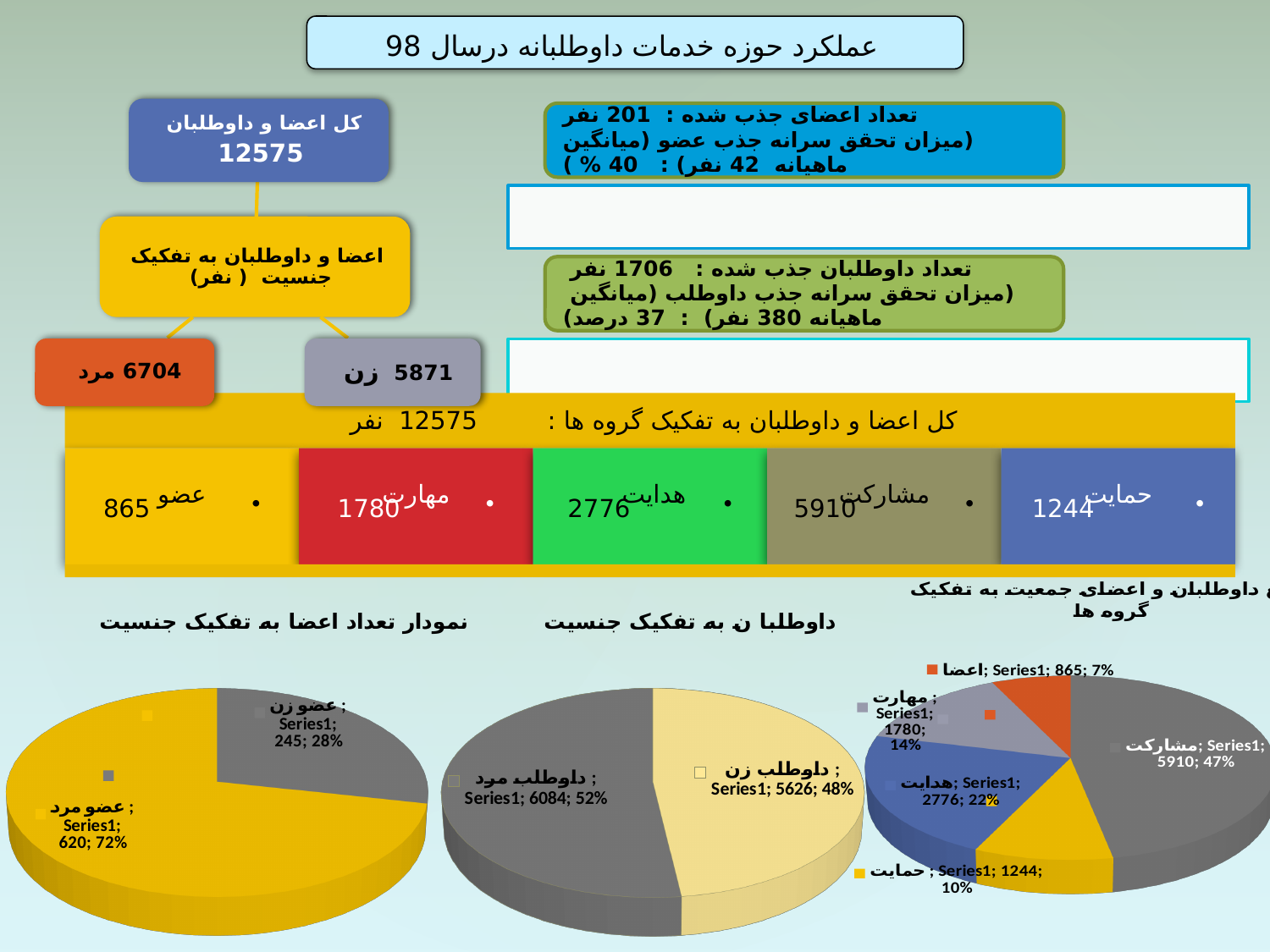
In the middle pie chart (داوطلبان به تفکیک جنسیت), which slice is larger, داوطلب مرد or داوطلب زن? داوطلب مرد In the left pie chart (نمودار تعداد اعضا به تفکیک جنسیت), what share of the pie does عضو زن represent? 28% In the left pie chart (نمودار تعداد اعضا به تفکیک جنسیت), what is the value for عضو مرد? 620 In the right pie chart (داوطلبان و اعضای جمعیت به تفکیک گروه ها), which category has the highest value? مشارکت In the middle pie chart (داوطلبان به تفکیک جنسیت), what share of the pie does داوطلب مرد represent? 52% In the right pie chart (داوطلبان و اعضای جمعیت به تفکیک گروه ها), what share of the pie does مهارت represent? 14% In the right pie chart (داوطلبان و اعضای جمعیت به تفکیک گروه ها), which category has the lowest value? اعضا What type of chart is the middle chart (داوطلبان به تفکیک جنسیت)? Pie chart In the left pie chart (نمودار تعداد اعضا به تفکیک جنسیت), what is the difference between عضو مرد and عضو زن? 375 In the right pie chart (داوطلبان و اعضای جمعیت به تفکیک گروه ها), how many categories are shown? 5 In the middle pie chart (داوطلبان به تفکیک جنسیت), what is the value for داوطلب زن? 5626 In the right pie chart (داوطلبان و اعضای جمعیت به تفکیک گروه ها), what is the value for هدایت? 2776